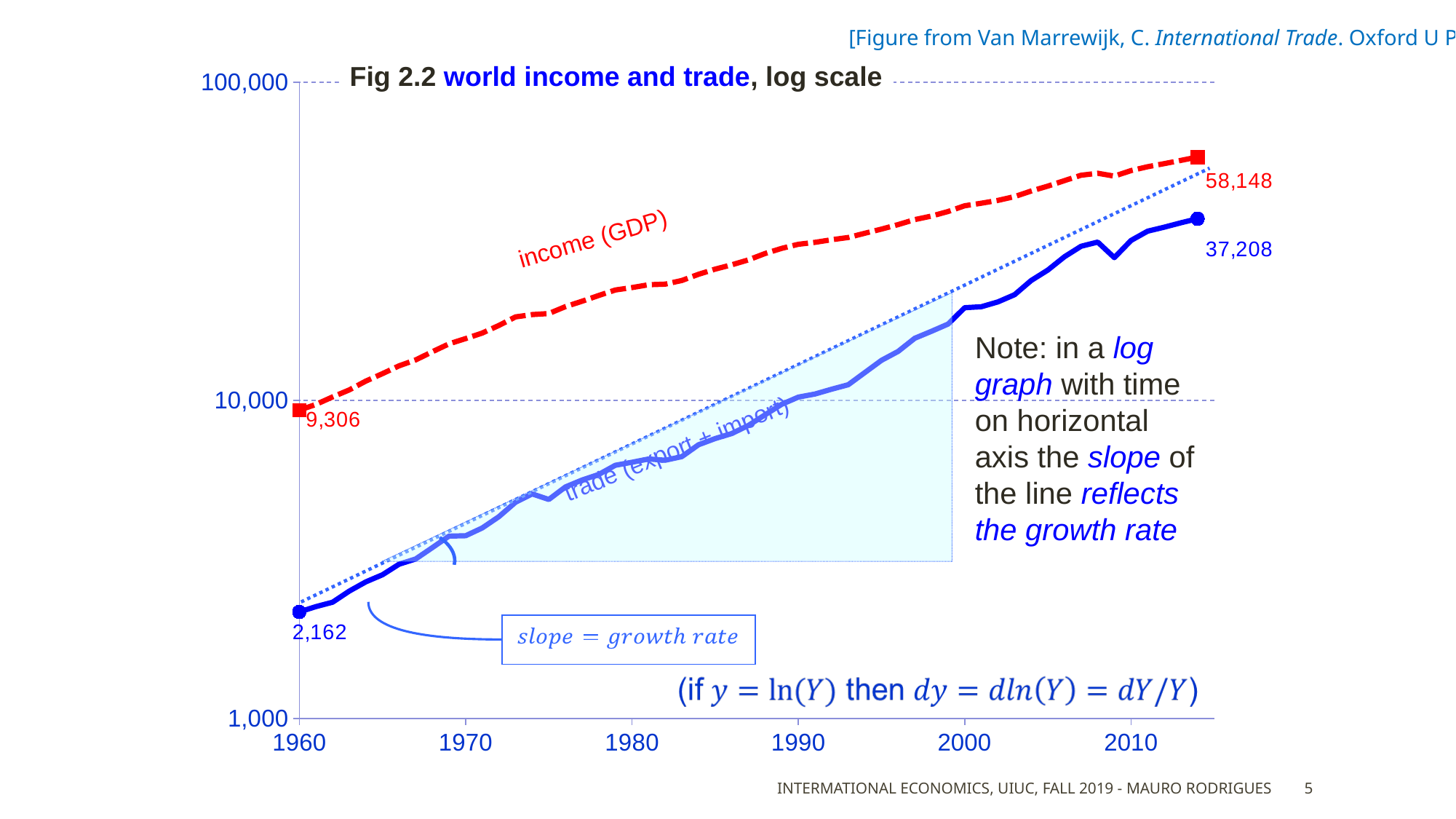
What is the title of the chart? Fig 2.2 world income and trade, log scale What is the value of income (GDP) in 1960? 9,306 What is the final labelled value of the income (GDP) series? 58,148 What is the value of trade (export + import) in 1960? 2,162 What is the difference between the final labelled values of income (GDP) and trade (export + import)? 20,940 Which series is drawn as a red dashed line? income (GDP) Does the trade (export + import) series rise or fall from 1960 to the end of the series? rise What is the final labelled value of the trade (export + import) series? 37,208 Which series has the higher value in 1960, income (GDP) or trade (export + import)? income (GDP) What kind of chart is shown on the slide? line chart What is the difference between income (GDP) and trade (export + import) in 1960? 7,144